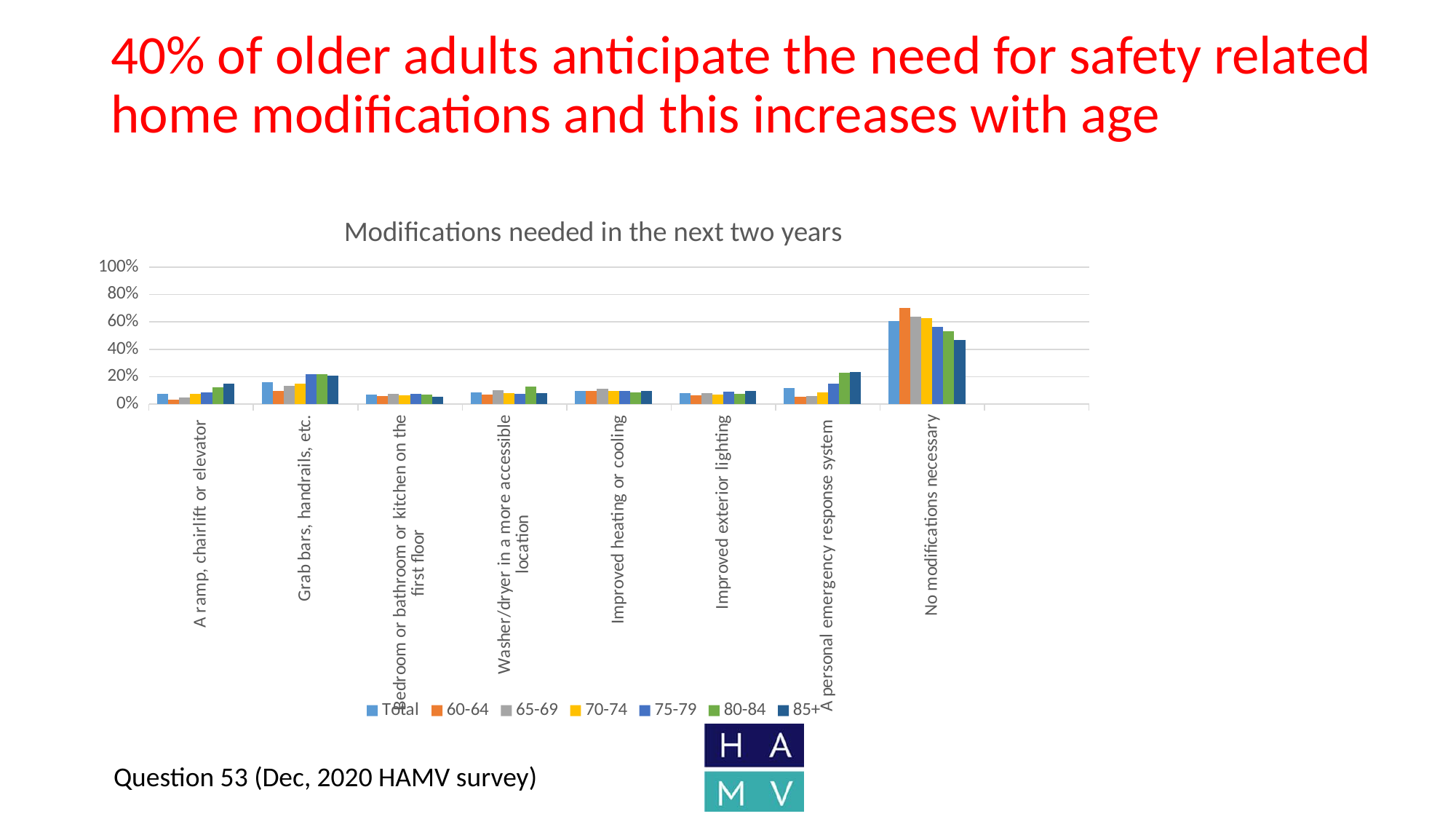
How many series does the legend list? 7 Which category has the highest bars in the chart? No modifications necessary Is the Total value for 'No modifications necessary' greater or less than 40%? greater Is the 60-64 value for 'No modifications necessary' greater or less than 60%? greater Is the Total value for 'Grab bars, handrails, etc.' greater or less than 20%? less What kind of chart is shown on the slide? bar chart For 'A personal emergency response system', which is larger: the 80-84 value or the 60-64 value? 80-84 For 'No modifications necessary', which is larger: the 60-64 value or the 85+ value? 60-64 What is the title of the chart? Modifications needed in the next two years How many modification categories are shown on the x axis? 8 For 'A ramp, chairlift or elevator', do the values rise or fall as the age group goes from 60-64 to 85+? rise